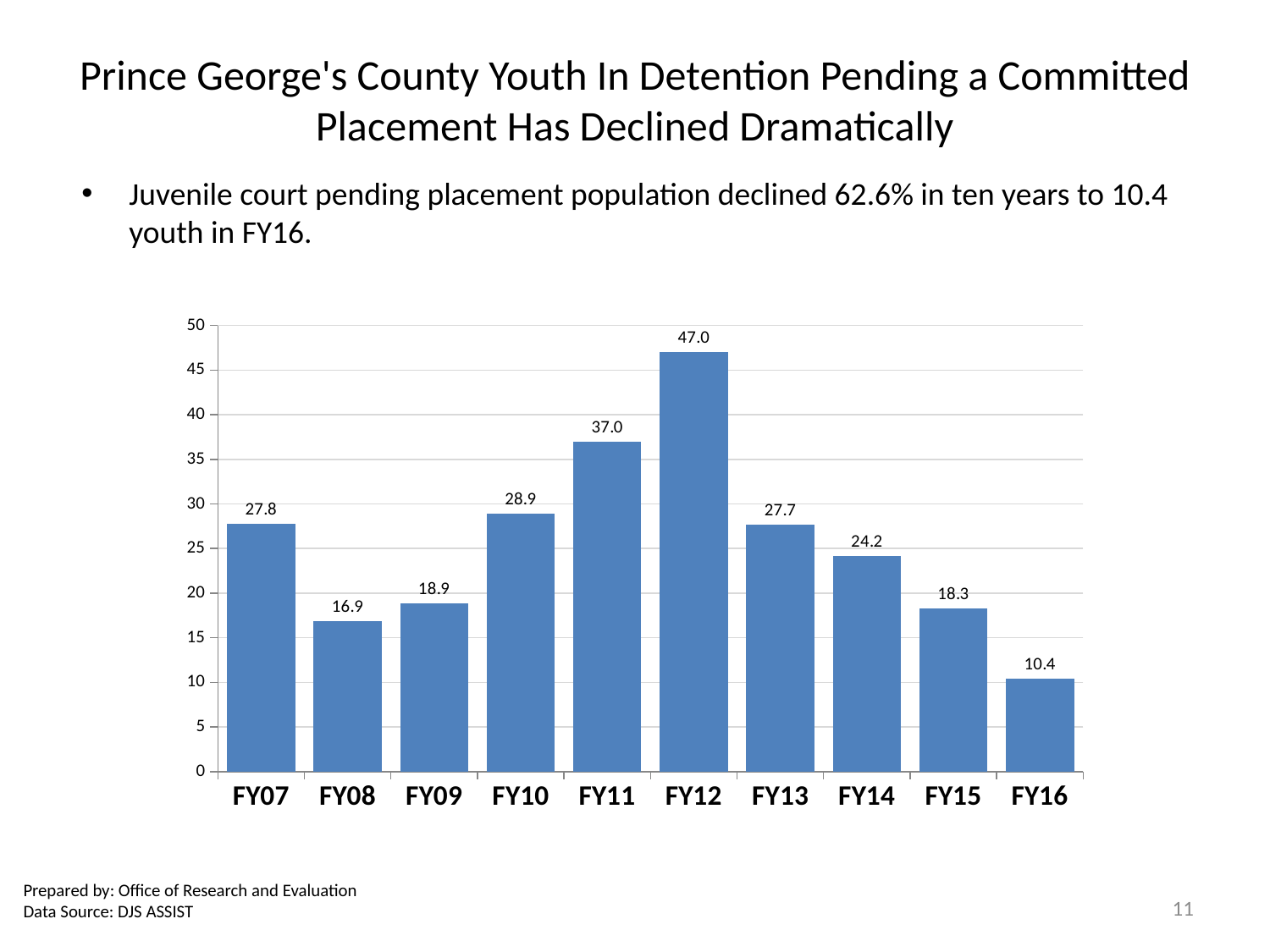
What is the difference between the values for FY11 and FY10? 8.1 How many fiscal years are shown on the x axis? 10 What is the value for FY16? 10.4 What kind of chart is shown on the slide? bar chart Which is larger, the value for FY07 or the value for FY14? FY07 What is the value for FY12? 47.0 Is the value for FY13 greater or less than 25? greater What is the difference between the values for FY12 and FY16? 36.6 Do the values rise or fall from FY12 to FY16? fall What is the value for FY08? 16.9 Which fiscal year has the highest value? FY12 Which fiscal year has the lowest value? FY16